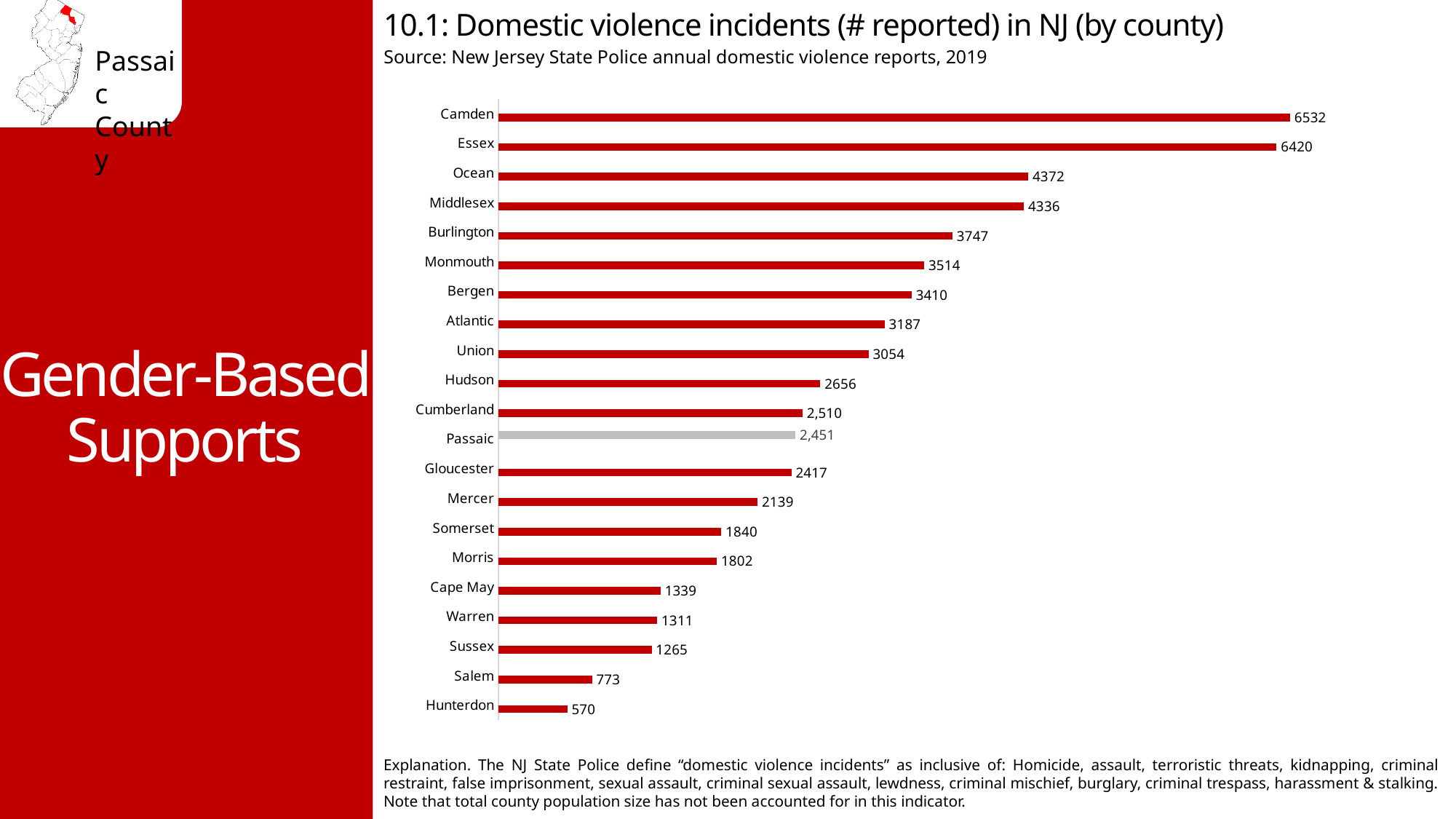
What is the difference in reported domestic violence incidents between Cumberland and Passaic? 59 What is the number of reported domestic violence incidents for Passaic county? 2,451 What is the number of reported domestic violence incidents for Camden county? 6532 Which county has the lowest number of reported domestic violence incidents? Hunterdon Which county's bar is shown in grey rather than red? Passaic Which county has more reported domestic violence incidents, Salem or Sussex? Sussex How many counties are shown in the chart? 21 What type of chart is used to show domestic violence incidents by county? Bar chart What is the difference in reported domestic violence incidents between Camden and Essex? 112 Which county has the highest number of reported domestic violence incidents? Camden Which county has more reported domestic violence incidents, Burlington or Bergen? Burlington What is the number of reported domestic violence incidents for Morris county? 1802